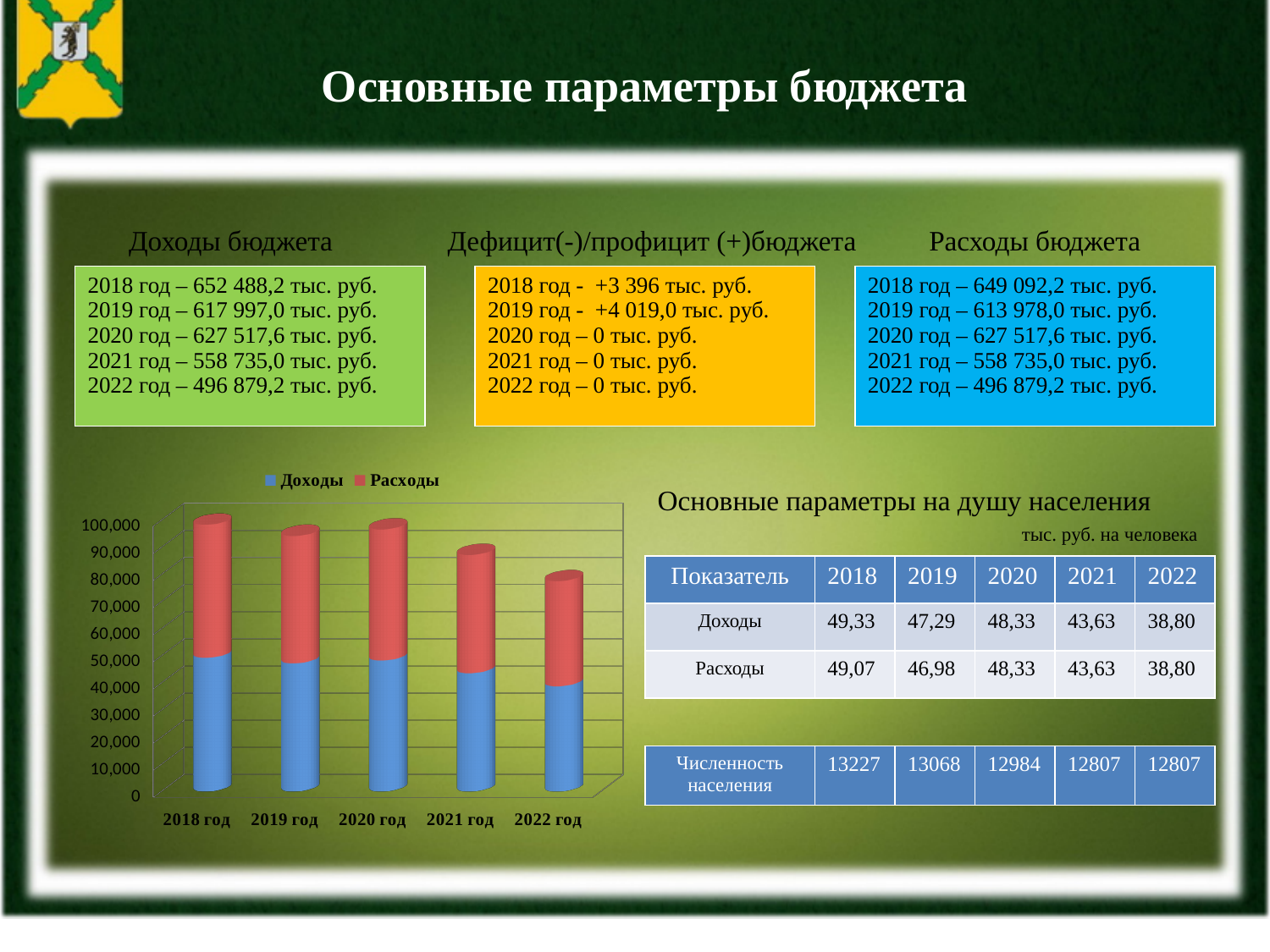
Which year has the highest total stacked bar in the chart? 2018 год What are the two series named in the chart legend? Доходы and Расходы Is the total stacked bar for 2022 год greater or less than 90,000? less How many year categories are shown on the x axis of the chart? 5 Do the total bar heights in the chart generally rise or fall from 2018 год to 2022 год? fall Which year has the lowest total stacked bar in the chart? 2022 год Which series in the chart is shown in blue? Доходы Is the Доходы value for 2022 год greater or less than 50,000? less Is the total stacked bar for 2018 год greater or less than 90,000? greater What kind of chart is shown on the slide? bar chart How many series does the chart legend list? 2 Which has the larger total stacked bar, 2021 год or 2022 год? 2021 год